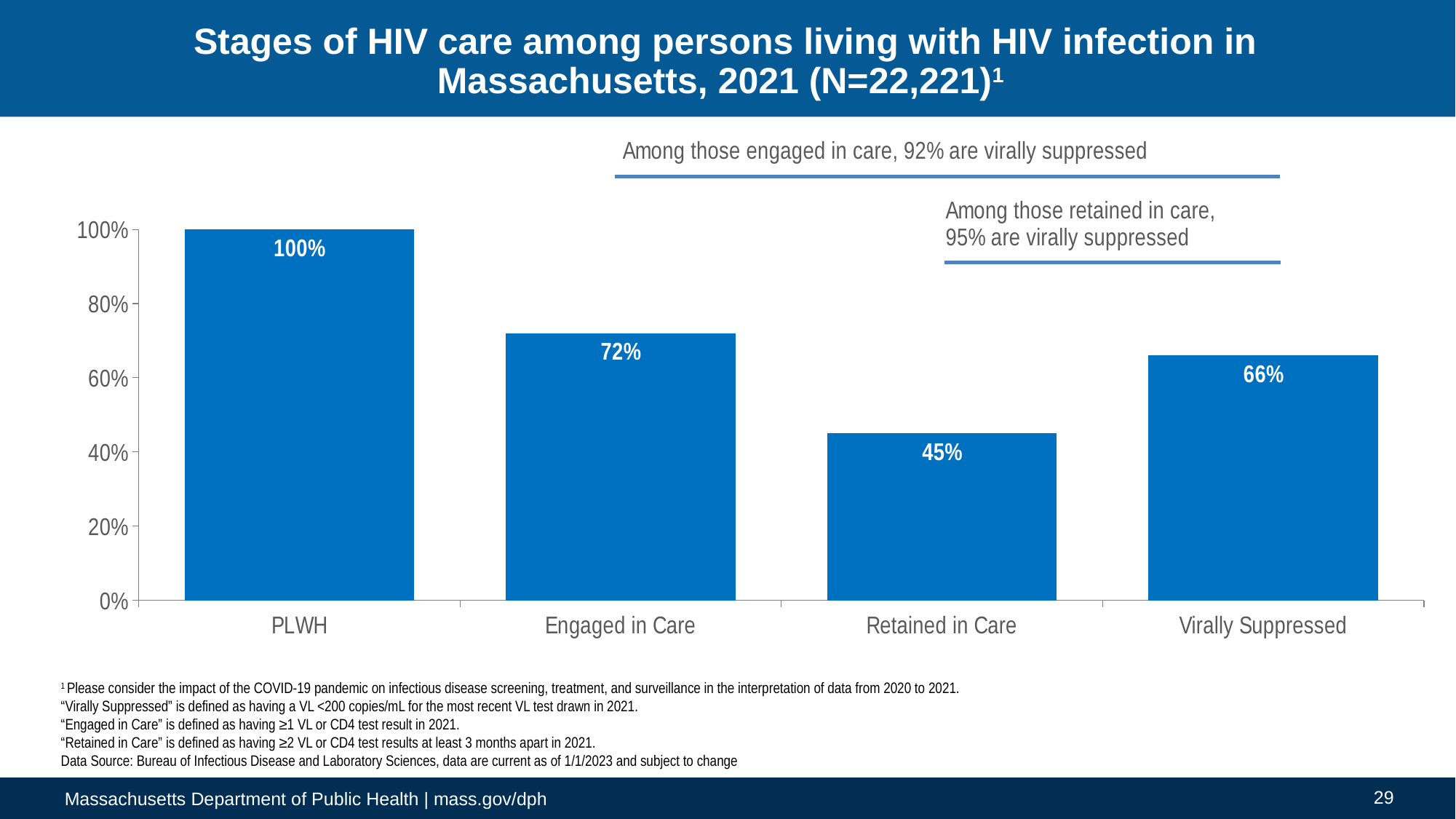
What kind of chart is shown on the slide? bar chart Is the value for Retained in Care greater or less than 60%? less What is the value for Virally Suppressed? 66% What is the value for PLWH? 100% According to the annotation on the chart, what percentage of those retained in care are virally suppressed? 95% What is the difference between the values for Engaged in Care and Retained in Care? 27% What is the value for Engaged in Care? 72% Which category has the lowest value? Retained in Care Which category has the highest value? PLWH What is the value for Retained in Care? 45% Which is larger, the value for Engaged in Care or the value for Virally Suppressed? Engaged in Care How many categories are shown on the x axis? 4